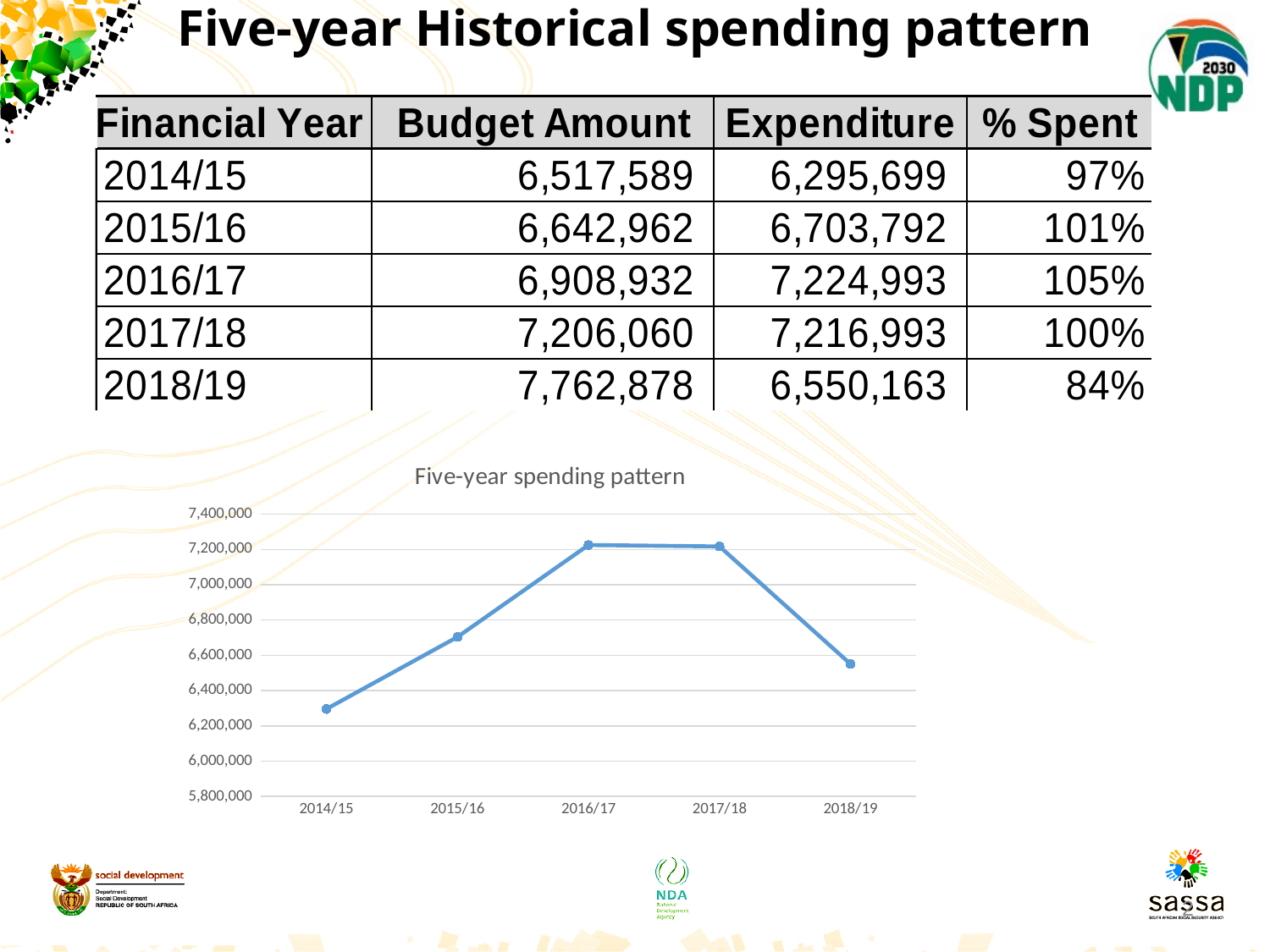
What kind of chart is the "Five-year spending pattern" chart? line chart On the "Five-year spending pattern" chart, is the value for 2015/16 greater or less than 6,800,000? less Does the line on the "Five-year spending pattern" chart rise or fall from 2017/18 to 2018/19? fall On the "Five-year spending pattern" chart, is the value for 2016/17 greater or less than 7,000,000? greater What is the title of the chart on the slide? Five-year spending pattern How many financial years are plotted on the "Five-year spending pattern" chart? 5 According to the table, what is the Expenditure for 2018/19, the last point plotted on the "Five-year spending pattern" chart? 6,550,163 Does the line on the "Five-year spending pattern" chart rise or fall from 2014/15 to 2016/17? rise Which financial year has the lowest value on the "Five-year spending pattern" chart? 2014/15 On the "Five-year spending pattern" chart, which is larger, the value for 2015/16 or the value for 2018/19? 2015/16 On the "Five-year spending pattern" chart, is the value for 2018/19 greater or less than 6,600,000? less